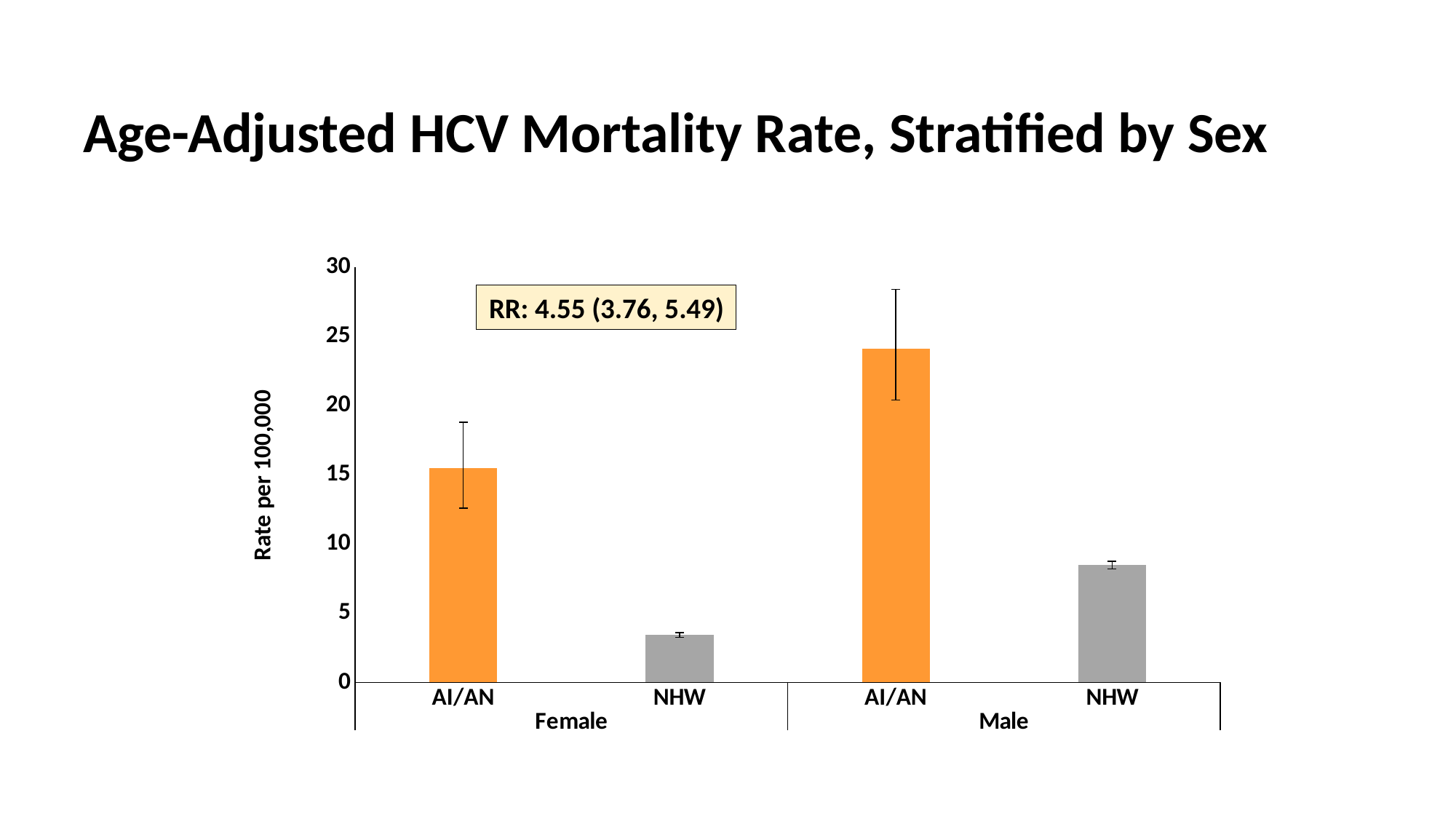
What kind of chart is shown on the slide? bar chart Which bar has the highest value? Male AI/AN Is the value for Female AI/AN greater or less than 10? greater Which is larger, the rate for Male NHW or Female NHW? Male NHW Is the value for Female NHW greater or less than 5? less Is the value for Male AI/AN greater or less than 20? greater Which is larger, the rate for Male AI/AN or Female AI/AN? Male AI/AN Which bar has the lowest value? Female NHW How many bars are plotted in the chart? 4 What is the label on the y axis of the chart? Rate per 100,000 What relative risk (RR) is shown in the box on the chart? RR: 4.55 (3.76, 5.49)